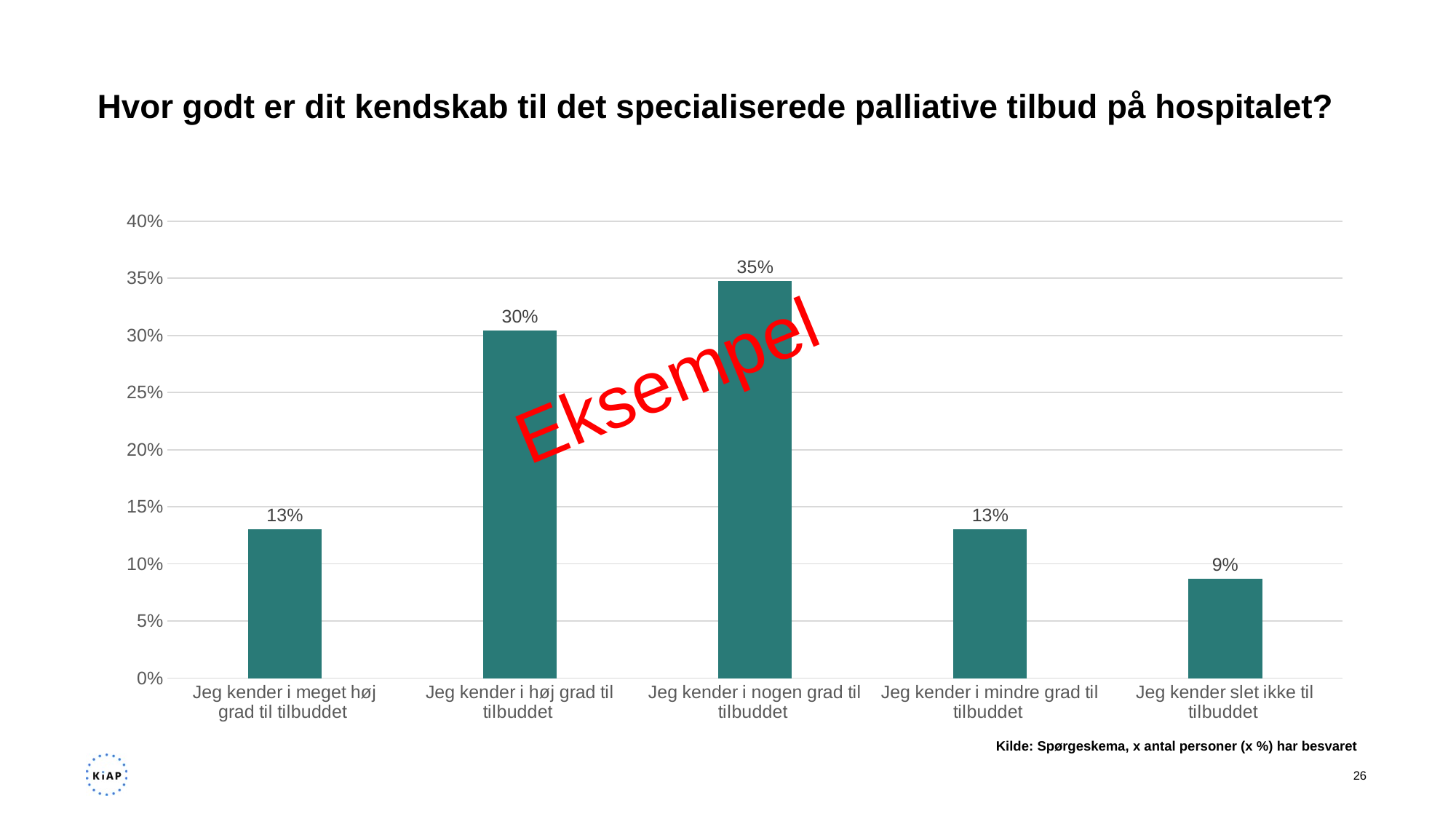
Which is larger: the value for "Jeg kender i høj grad til tilbuddet" or the value for "Jeg kender i mindre grad til tilbuddet"? Jeg kender i høj grad til tilbuddet What is the difference between the values for "Jeg kender i nogen grad til tilbuddet" and "Jeg kender i høj grad til tilbuddet"? 5% What is the value for "Jeg kender i meget høj grad til tilbuddet"? 13% Which category has the lowest value? Jeg kender slet ikke til tilbuddet What is the value for "Jeg kender i høj grad til tilbuddet"? 30% How many categories are shown on the x axis? 5 What is the value for "Jeg kender slet ikke til tilbuddet"? 9% Which category has the highest value? Jeg kender i nogen grad til tilbuddet What is the value for "Jeg kender i nogen grad til tilbuddet"? 35% Is the value for "Jeg kender slet ikke til tilbuddet" greater or less than 10%? less What is the title of the chart? Hvor godt er dit kendskab til det specialiserede palliative tilbud på hospitalet? What kind of chart is shown on the slide? bar chart